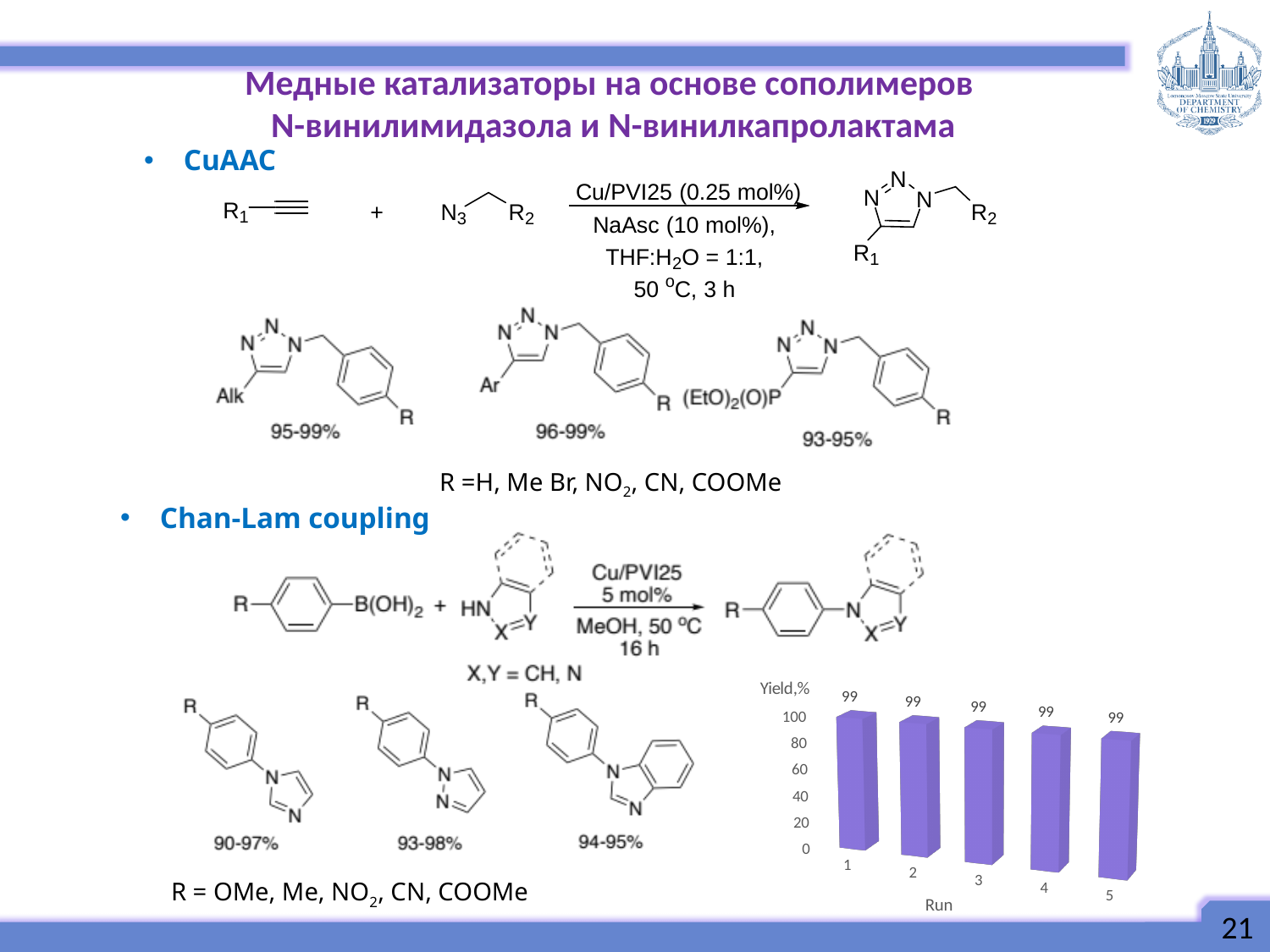
Do the yields in the bar chart rise, fall, or stay the same from run 1 to run 5? stay the same What is the yield for run 3 in the bar chart? 99 What is the yield for run 1 in the bar chart? 99 What is the yield for run 5 in the bar chart? 99 What is the label of the vertical axis of the bar chart? Yield,% Is the yield for run 2 in the bar chart greater or less than 80? greater What is the label of the horizontal axis of the bar chart? Run What is the highest tick value shown on the vertical axis of the bar chart? 100 How many runs are plotted in the bar chart? 5 What is the difference between the yield for run 1 and the yield for run 4 in the bar chart? 0 What kind of chart is shown at the bottom right of the slide? bar chart